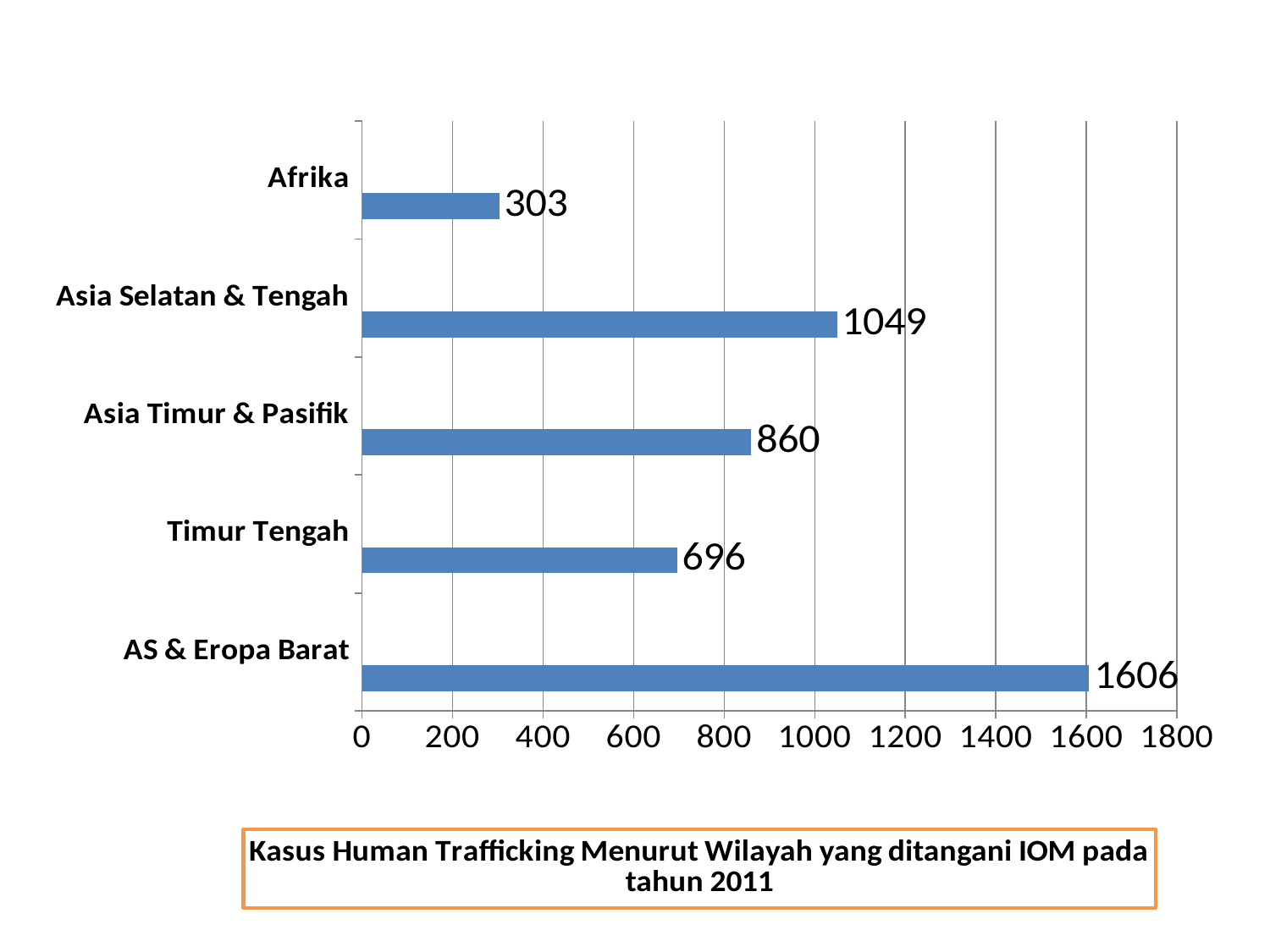
What kind of chart is shown on the slide? bar chart What is the difference between the values for AS & Eropa Barat and Asia Selatan & Tengah? 557 Is the value for Asia Selatan & Tengah greater or less than 1000? greater How many regions are shown in the chart? 5 What is the value for AS & Eropa Barat? 1606 What is the difference between the values for Asia Timur & Pasifik and Timur Tengah? 164 What is the title shown below the chart? Kasus Human Trafficking Menurut Wilayah yang ditangani IOM pada tahun 2011 Which region has the lowest value? Afrika Which region has the highest value? AS & Eropa Barat What is the value for Afrika? 303 What is the value for Asia Selatan & Tengah? 1049 Which is larger, the value for Timur Tengah or the value for Asia Timur & Pasifik? Asia Timur & Pasifik